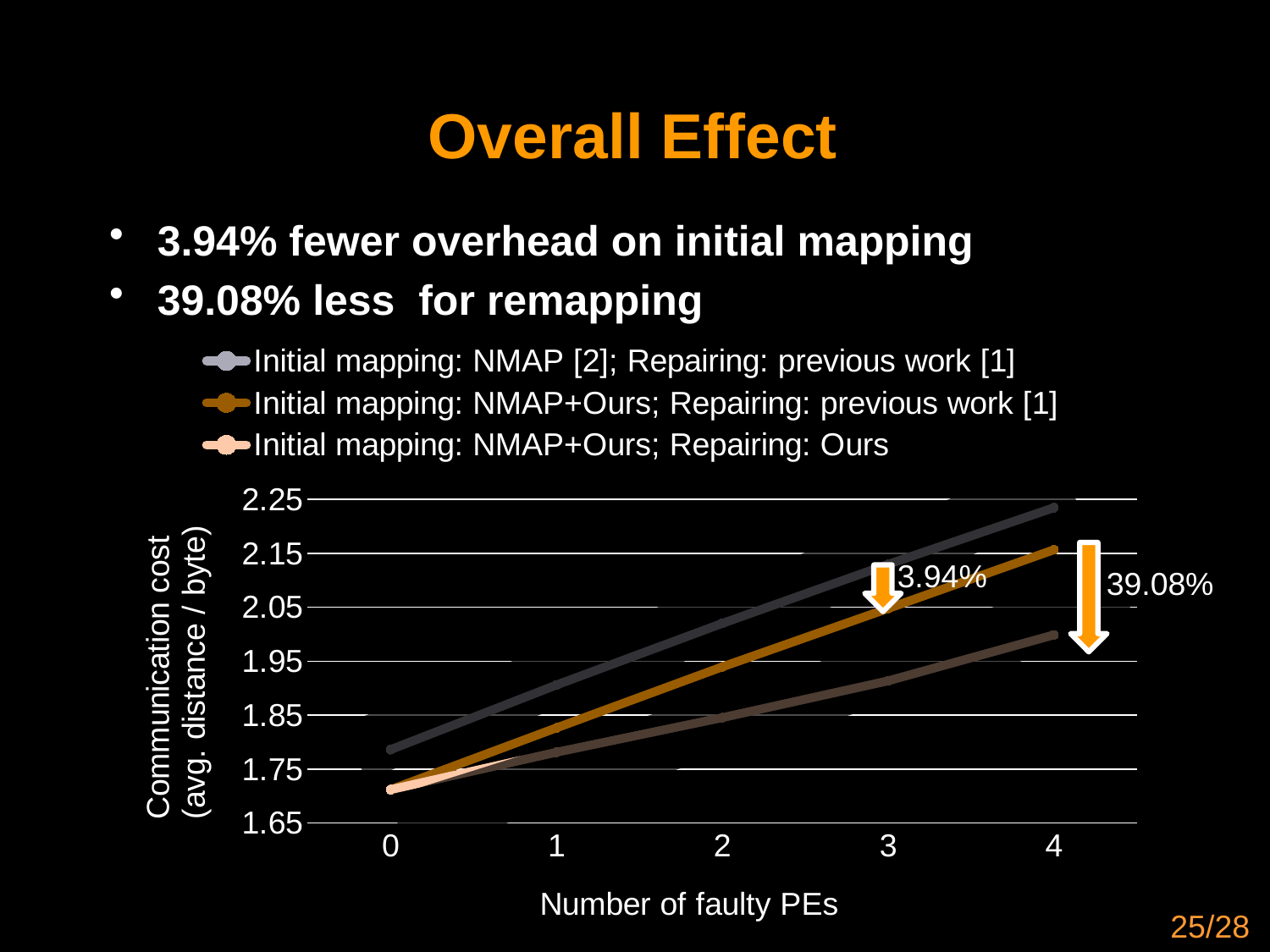
Which series has the lowest communication cost at 4 faulty PEs? Initial mapping: NMAP+Ours; Repairing: Ours Which series has the highest communication cost at 4 faulty PEs? Initial mapping: NMAP [2]; Repairing: previous work [1] Is the communication cost for 'Initial mapping: NMAP [2]; Repairing: previous work [1]' at 4 faulty PEs greater or less than 2.15? greater How many values of 'Number of faulty PEs' are shown on the x axis? 5 What kind of chart is shown on the slide? line chart Is the communication cost for 'Initial mapping: NMAP+Ours; Repairing: previous work [1]' at 4 faulty PEs greater or less than 2.05? greater Do the communication cost values rise or fall as the number of faulty PEs increases? rise At 4 faulty PEs, which is larger: the communication cost for 'Initial mapping: NMAP [2]; Repairing: previous work [1]' or for 'Initial mapping: NMAP+Ours; Repairing: Ours'? Initial mapping: NMAP [2]; Repairing: previous work [1] What percentage reduction is annotated by the large arrow at the right of the chart? 39.08% How many series does the legend list? 3 Is the communication cost for 'Initial mapping: NMAP+Ours; Repairing: Ours' at 0 faulty PEs greater or less than 1.75? less What is the title of the x axis of the chart? Number of faulty PEs